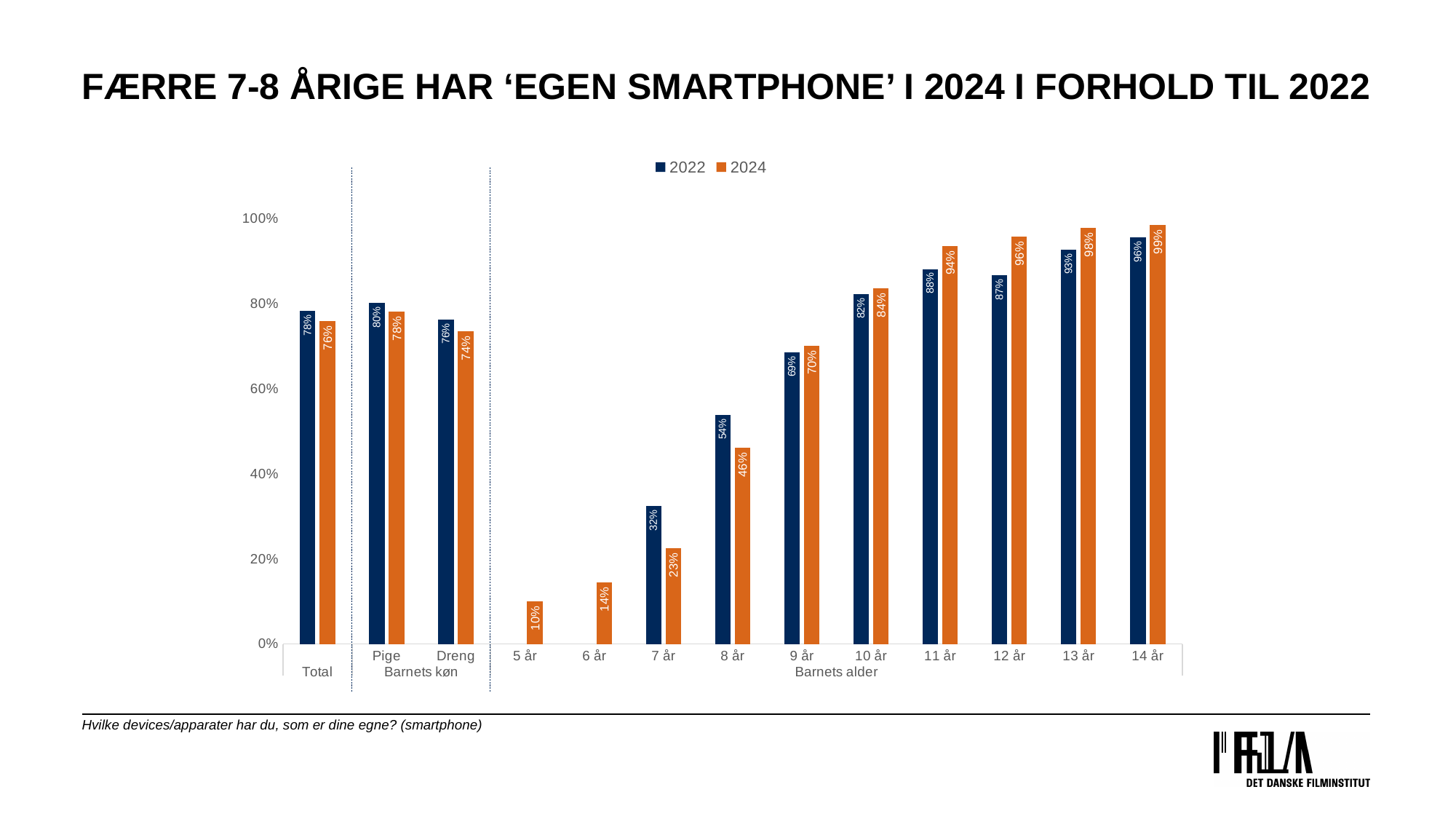
What is the difference between the 2022 and 2024 values for 7 år? 9 percentage points Which age category has the highest value in the 2024 series? 14 år What is the value for Pige in the 2024 series? 78% What is the value for 5 år in the 2024 series? 10% How many series does the legend list? 2 What is the value for 7 år in the 2022 series? 32% Which category has the lowest value in the 2024 series? 5 år Which is larger for 8 år: the 2022 value or the 2024 value? 2022 What is the difference between the 2022 and 2024 values for 12 år? 9 percentage points What kind of chart is shown on the slide? Bar chart What is the value for 8 år in the 2024 series? 46% Do the 2024 values rise or fall as the child's age increases from 5 år to 14 år? Rise